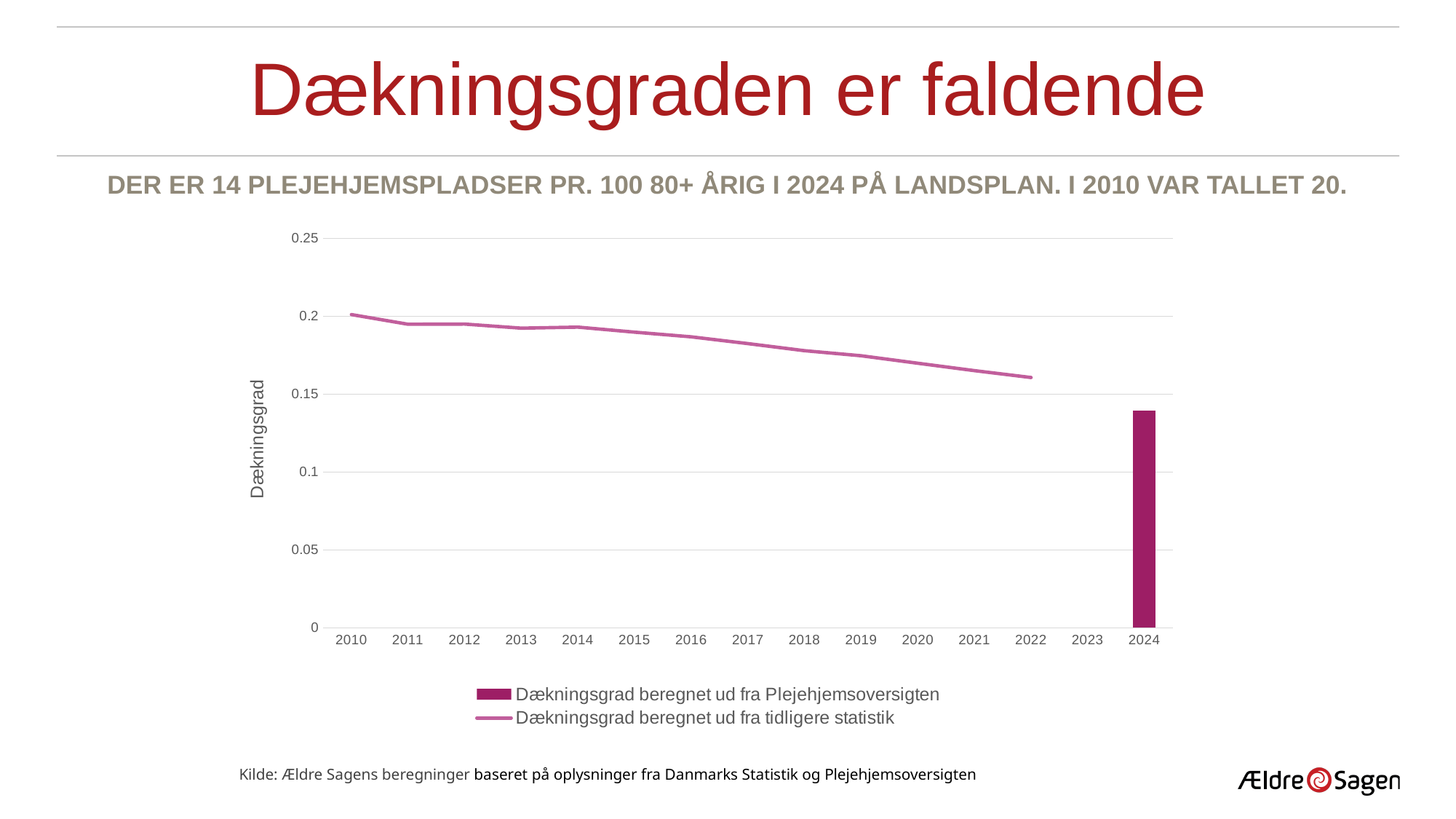
Which year has the highest value on the line 'Dækningsgrad beregnet ud fra tidligere statistik'? 2010 What is the title of the y axis? Dækningsgrad Which is larger, the line value for 2022 or the bar value for 2024? 2022 What kind of chart is shown on the slide? A combined line and bar chart Which is larger, the line value for 2010 or the line value for 2022? 2010 How many series does the legend list? 2 Which year has the lowest value on the line 'Dækningsgrad beregnet ud fra tidligere statistik'? 2022 Is the value for 2022 on the line greater or less than 0.15? greater Does the line for 'Dækningsgrad beregnet ud fra tidligere statistik' rise or fall from 2010 to 2022? Fall Is the value of the 2024 bar greater or less than 0.15? less Is the value for 2022 on the line greater or less than 0.2? less How many years are shown on the x axis? 15